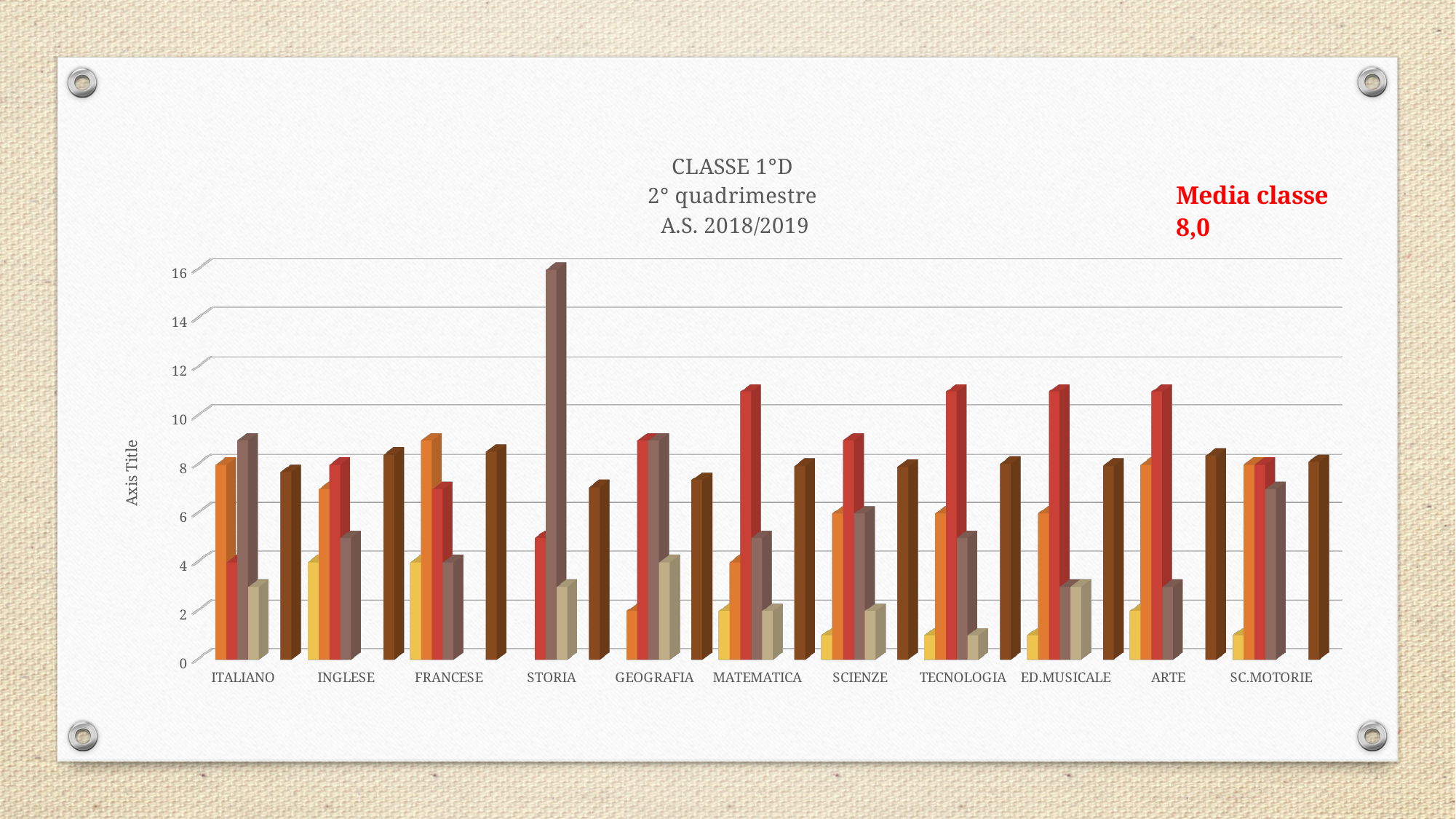
How many subject categories are shown along the x axis? 11 What kind of chart is shown on the slide? bar chart Is the dark brown bar for GEOGRAFIA greater or less than 8? less Is the red bar for ITALIANO greater or less than 6? less Is the orange bar for FRANCESE greater or less than 8? greater What is the title of the chart? CLASSE 1°D 2° quadrimestre A.S. 2018/2019 What class average (Media classe) is written in red on the slide? 8,0 Which subject contains the tallest bar in the chart? STORIA